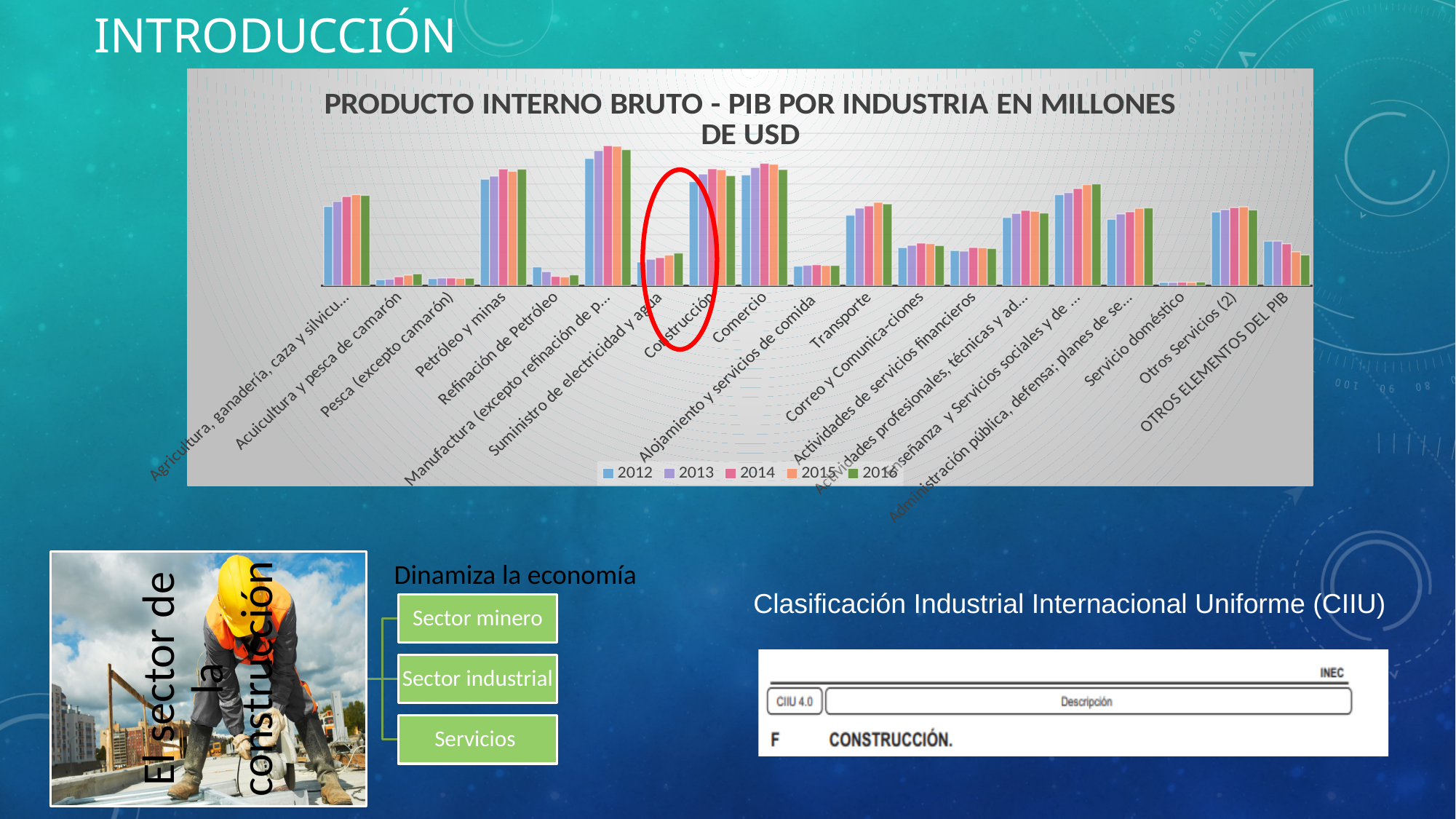
Which years are listed in the chart legend? 2012, 2013, 2014, 2015, 2016 Do the values for Suministro de electricidad y agua rise or fall from 2012 to 2016? rise How many industry categories are shown on the x axis? 19 Which has a larger PIB value in 2016, Construcción or Transporte? Construcción What kind of chart is shown on the slide? bar chart Which has a larger PIB value in 2014, Petróleo y minas or Agricultura, ganadería, caza y silvicu...? Petróleo y minas What is the title of the chart? PRODUCTO INTERNO BRUTO - PIB POR INDUSTRIA EN MILLONES DE USD Which industry has the lowest PIB values in the chart? Servicio doméstico How many series does the legend list? 5 Do the values for OTROS ELEMENTOS DEL PIB rise or fall from 2012 to 2016? fall Which has a larger PIB value in 2012, Refinación de Petróleo or Pesca (excepto camarón)? Refinación de Petróleo Which industry has the highest PIB values in the chart? Manufactura (excepto refinación de p...)